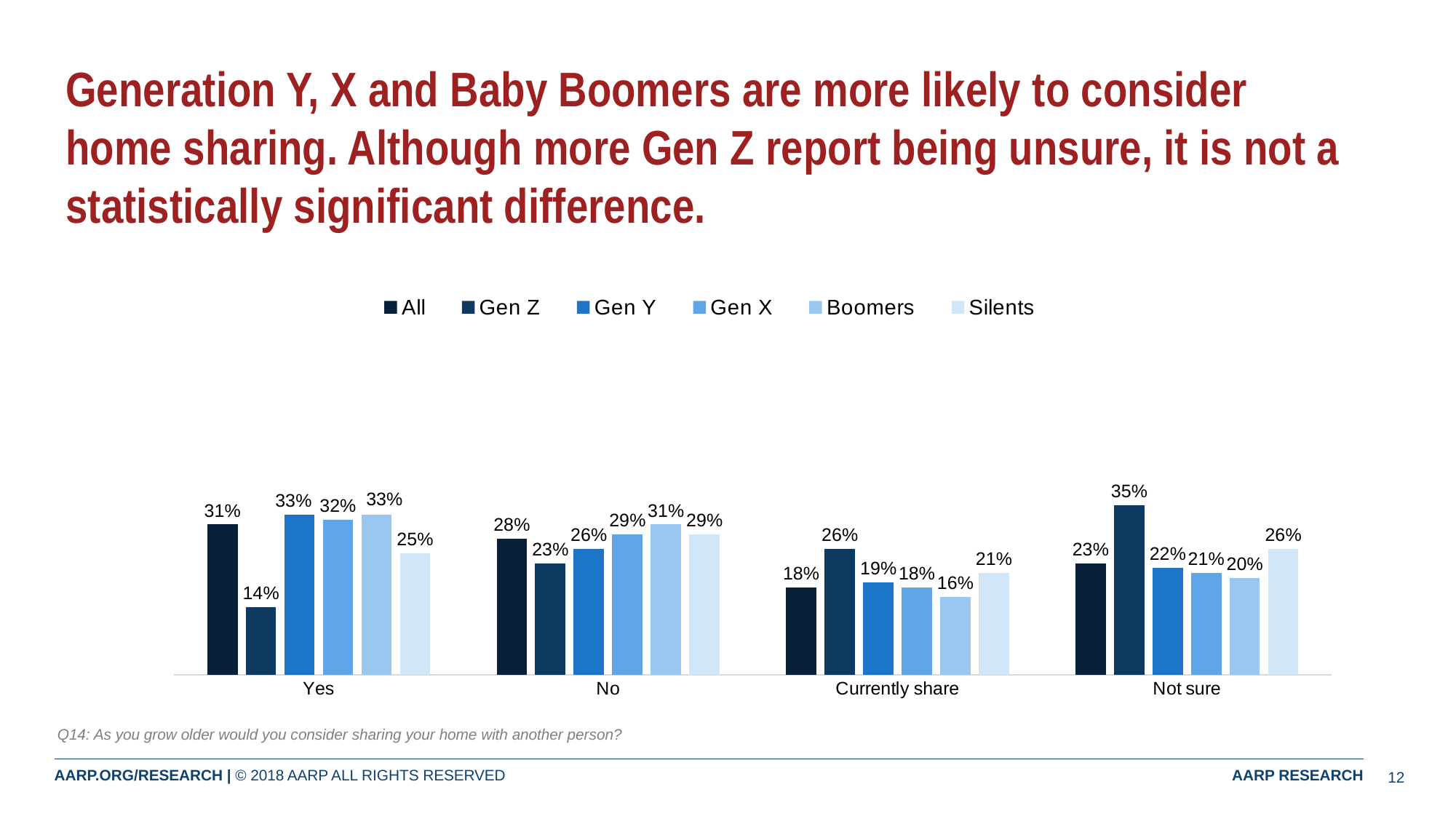
What percentage of Silents answered "Not sure"? 26% Which group has the lowest value in the "Yes" category? Gen Z Which group has the lowest value in the "Currently share" category? Boomers How many response categories are shown on the x axis? 4 What percentage of Gen Z respondents answered "Yes"? 14% What is the difference between the Gen Z and All values in the "Not sure" category? 12 percentage points What is the value for Boomers in the "No" category? 31% How many series does the legend list? 6 Which is larger in the "No" category: the value for Gen X or the value for Gen Z? Gen X What is the value for All respondents in the "Currently share" category? 18% What kind of chart is shown on the slide? Bar chart Which group has the highest value in the "Not sure" category? Gen Z